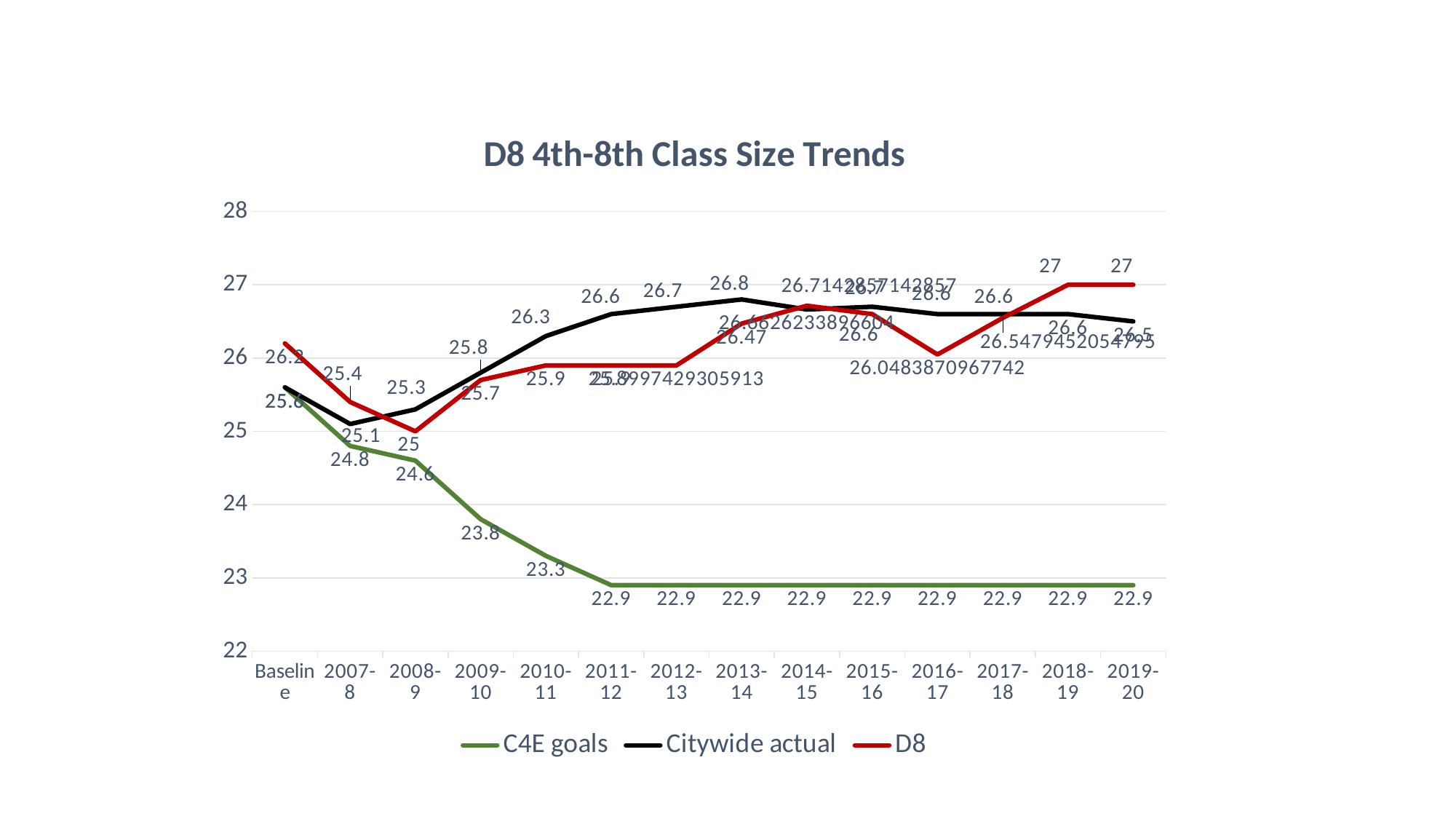
In which year is the Citywide actual value highest? 2013-14 How many series does the legend list? 3 What is the title of the chart? D8 4th-8th Class Size Trends In 2018-19, which is larger: the D8 value or the Citywide actual value? D8 What kind of chart is shown on the slide? line chart What is the Citywide actual value for 2013-14? 26.8 In which year is the D8 value lowest? 2008-9 What is the difference between the Citywide actual values for 2013-14 and 2019-20? 0.3 What is the C4E goals value for 2019-20? 22.9 How many categories are shown on the x axis? 14 What is the C4E goals value for 2009-10? 23.8 What is the D8 value for 2018-19? 27